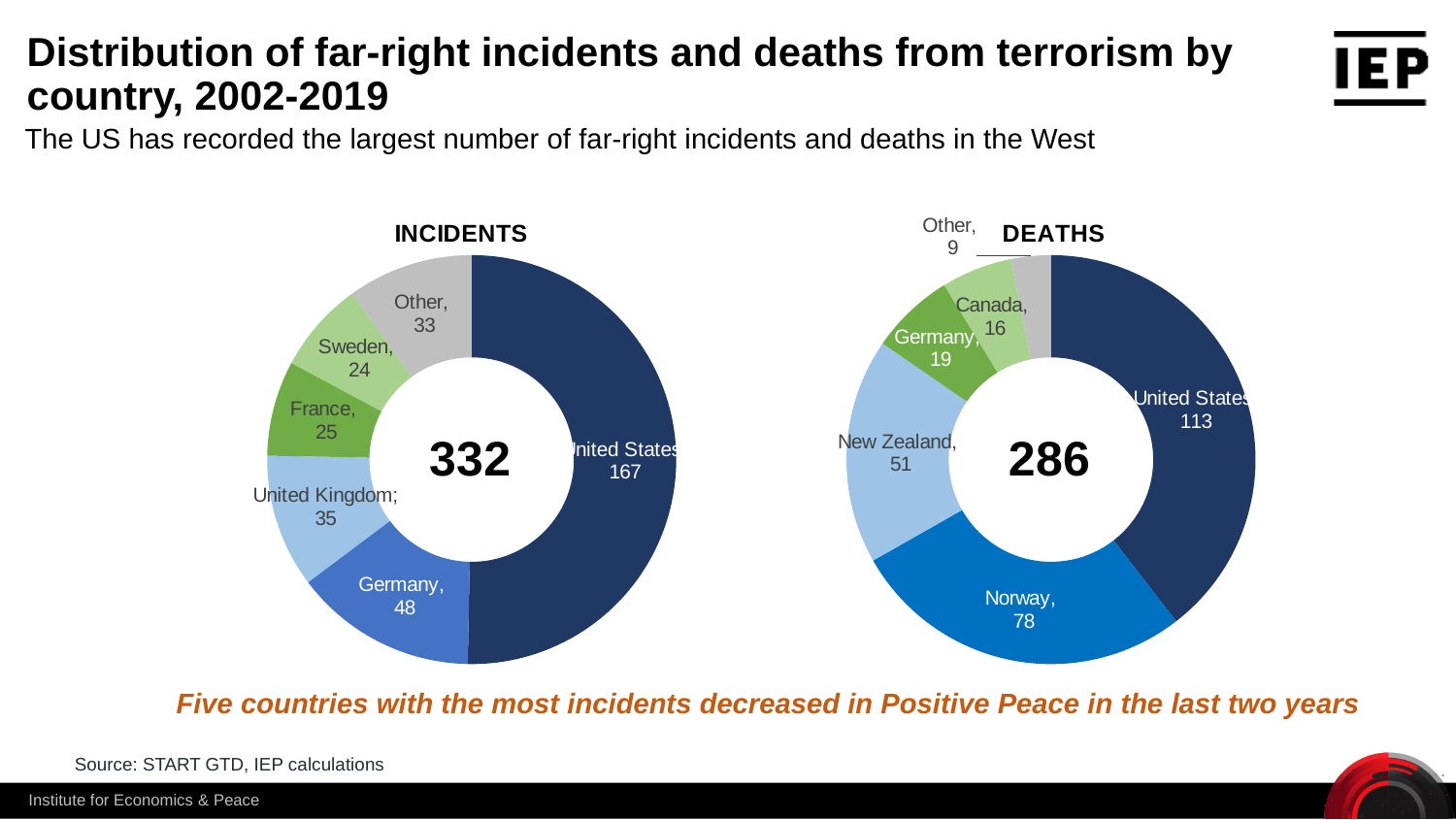
In the DEATHS chart, how many deaths are attributed to Norway? 78 In the DEATHS chart, what is the difference between the deaths for the United States and Norway? 35 In the INCIDENTS chart, how many far-right incidents are attributed to the United States? 167 In the INCIDENTS chart, how many slices does the donut have? 6 In the INCIDENTS chart, which country has the fewest incidents among the named countries? Sweden In the INCIDENTS chart, what is the difference between the incidents for Germany and the United Kingdom? 13 What is the total number shown in the centre of the INCIDENTS chart? 332 What type of chart is the DEATHS chart? Donut (pie) chart In the DEATHS chart, which category has the largest number of deaths? United States In the DEATHS chart, which has more deaths, New Zealand or Germany? New Zealand What is the source cited for the charts on the slide? START GTD, IEP calculations In the DEATHS chart, what is the combined number of deaths for Canada and Other? 25